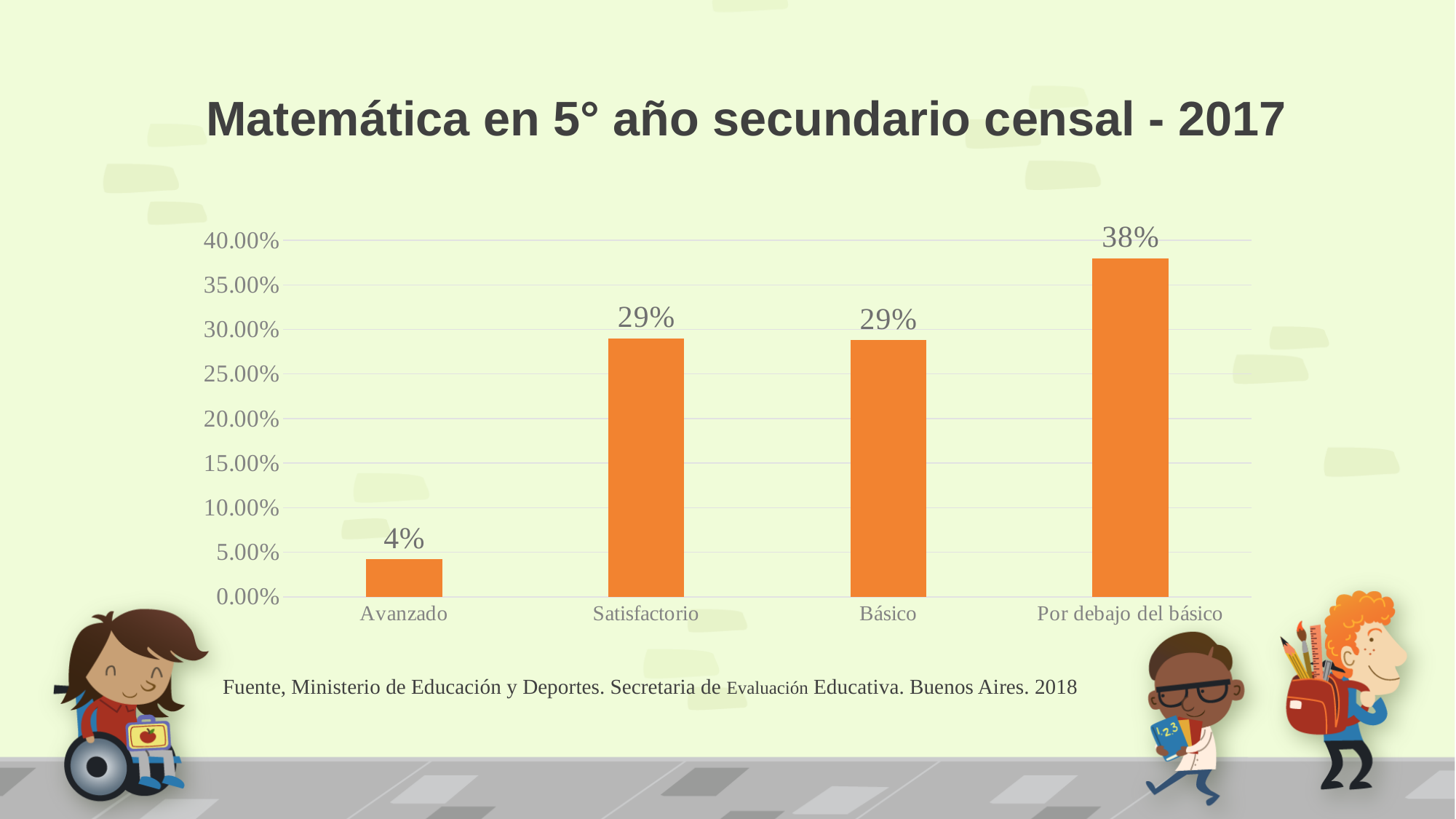
What kind of chart is shown on the slide? bar chart What colour are the bars in the chart? orange What is the value for Satisfactorio? 29% Which is larger, the value for Por debajo del básico or the value for Básico? Por debajo del básico What is the value for Avanzado? 4% What is the difference between the values for Por debajo del básico and Avanzado? 34% Which category has the highest value? Por debajo del básico Is the value for Básico greater or less than 20.00%? greater How many categories are shown on the x axis? 4 What is the title of the slide? Matemática en 5° año secundario censal - 2017 What is the value for Por debajo del básico? 38% Which category has the lowest value? Avanzado